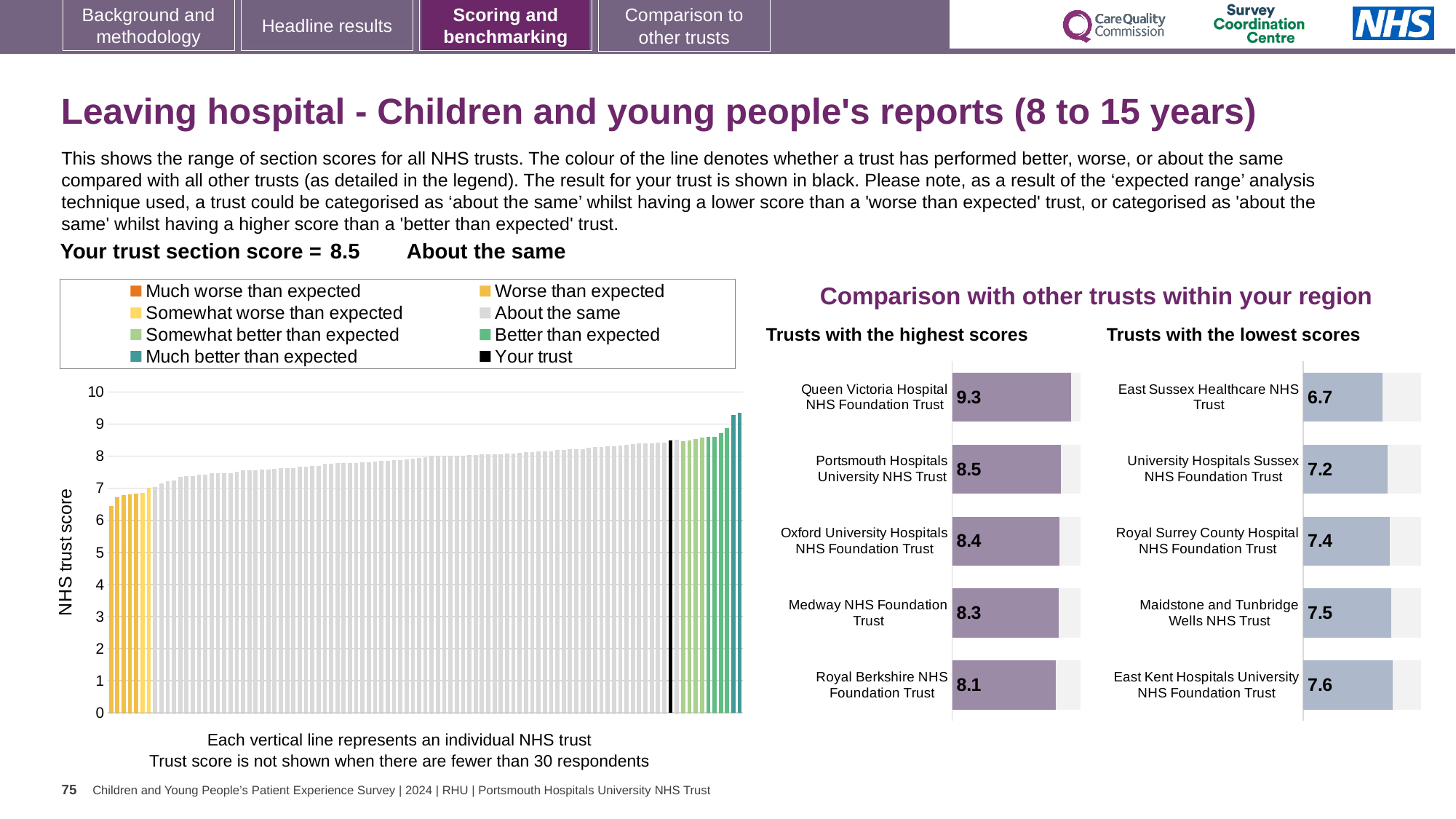
What kind of chart is the large chart on the left showing NHS trust scores? Bar chart In the 'Trusts with the highest scores' chart, which has the higher score: Oxford University Hospitals NHS Foundation Trust or Medway NHS Foundation Trust? Oxford University Hospitals NHS Foundation Trust In the large chart on the left, what colour denotes 'Your trust' according to the legend? Black In the 'Trusts with the lowest scores' chart, which trust has the lowest score? East Sussex Healthcare NHS Trust In the 'Trusts with the highest scores' chart, which trust has the highest score? Queen Victoria Hospital NHS Foundation Trust In the 'Trusts with the lowest scores' chart, what is the difference between the scores of East Kent Hospitals University NHS Foundation Trust and East Sussex Healthcare NHS Trust? 0.9 In the large chart on the left, do the trust scores rise or fall from left to right? Rise In the 'Trusts with the highest scores' chart, what is the score for Queen Victoria Hospital NHS Foundation Trust? 9.3 How many trusts are shown in the 'Trusts with the highest scores' chart? 5 In the 'Trusts with the lowest scores' chart, what is the score for Maidstone and Tunbridge Wells NHS Trust? 7.5 In the 'Trusts with the highest scores' chart, what is the difference between the scores of Queen Victoria Hospital NHS Foundation Trust and Royal Berkshire NHS Foundation Trust? 1.2 In the 'Trusts with the lowest scores' chart, what is the score for East Sussex Healthcare NHS Trust? 6.7